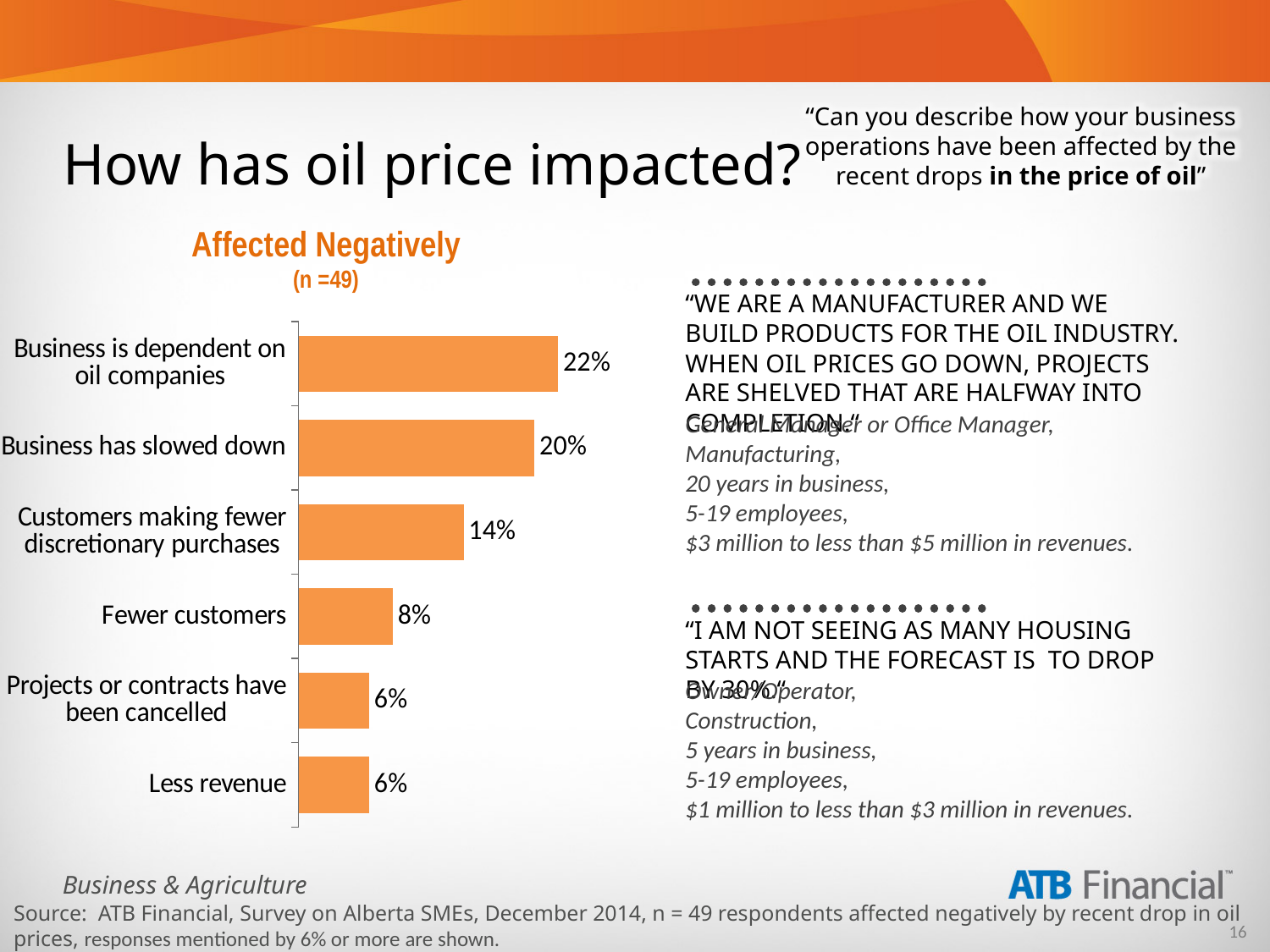
What type of chart is shown on the slide? Bar chart What is the difference between "Business is dependent on oil companies" and "Business has slowed down"? 2% Which category has the highest value in the chart? Business is dependent on oil companies Which is larger: "Business has slowed down" or "Customers making fewer discretionary purchases"? Business has slowed down What percentage is shown for "Customers making fewer discretionary purchases"? 14% What percentage of respondents said their business is dependent on oil companies? 22% How many categories are shown in the bar chart? 6 What is the title of the chart? Affected Negatively What is the difference between "Customers making fewer discretionary purchases" and "Fewer customers"? 6% What is the value for "Business has slowed down"? 20% What is the sample size (n) shown under the chart title? 49 What is the value for "Fewer customers"? 8%